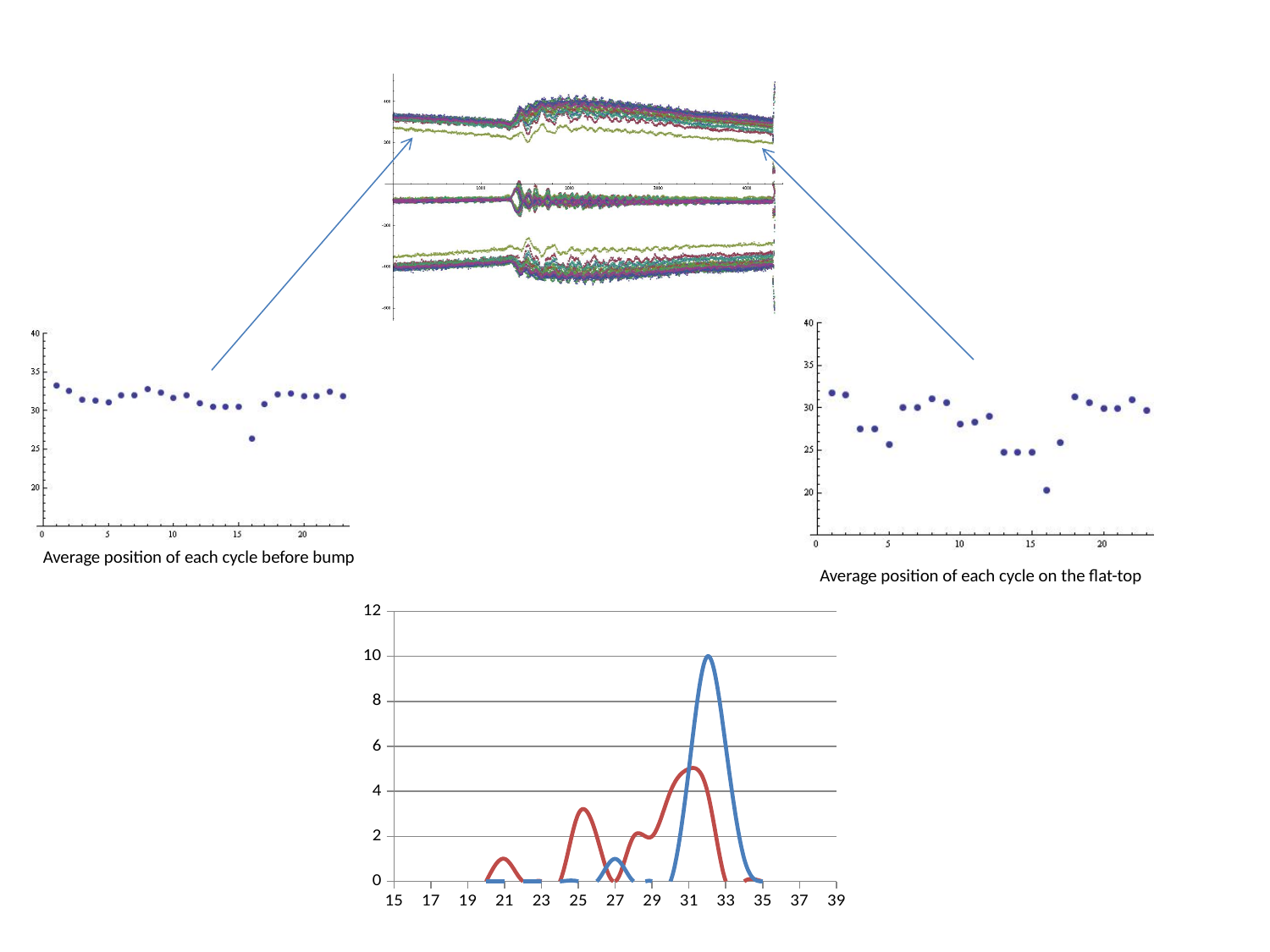
In the bottom line chart, is the peak of the red curve greater or less than 6? less What kind of chart is 'Average position of each cycle before bump'? scatter plot In the chart 'Average position of each cycle before bump', at which cycle number is the lowest point? 16 How many curves are plotted in the bottom line chart? 2 In the chart 'Average position of each cycle before bump', is the value at cycle 16 greater or less than 30? less In the bottom line chart, what is the peak value of the blue curve? 10 In the chart 'Average position of each cycle on the flat-top', at which cycle number is the lowest point? 16 In the chart 'Average position of each cycle on the flat-top', is the value at cycle 16 greater or less than 25? less What kind of chart is the bottom chart with the red and blue curves? line chart What is the highest value shown on the vertical axis of the bottom line chart? 12 In the bottom line chart, which curve reaches the higher peak, the red or the blue? blue